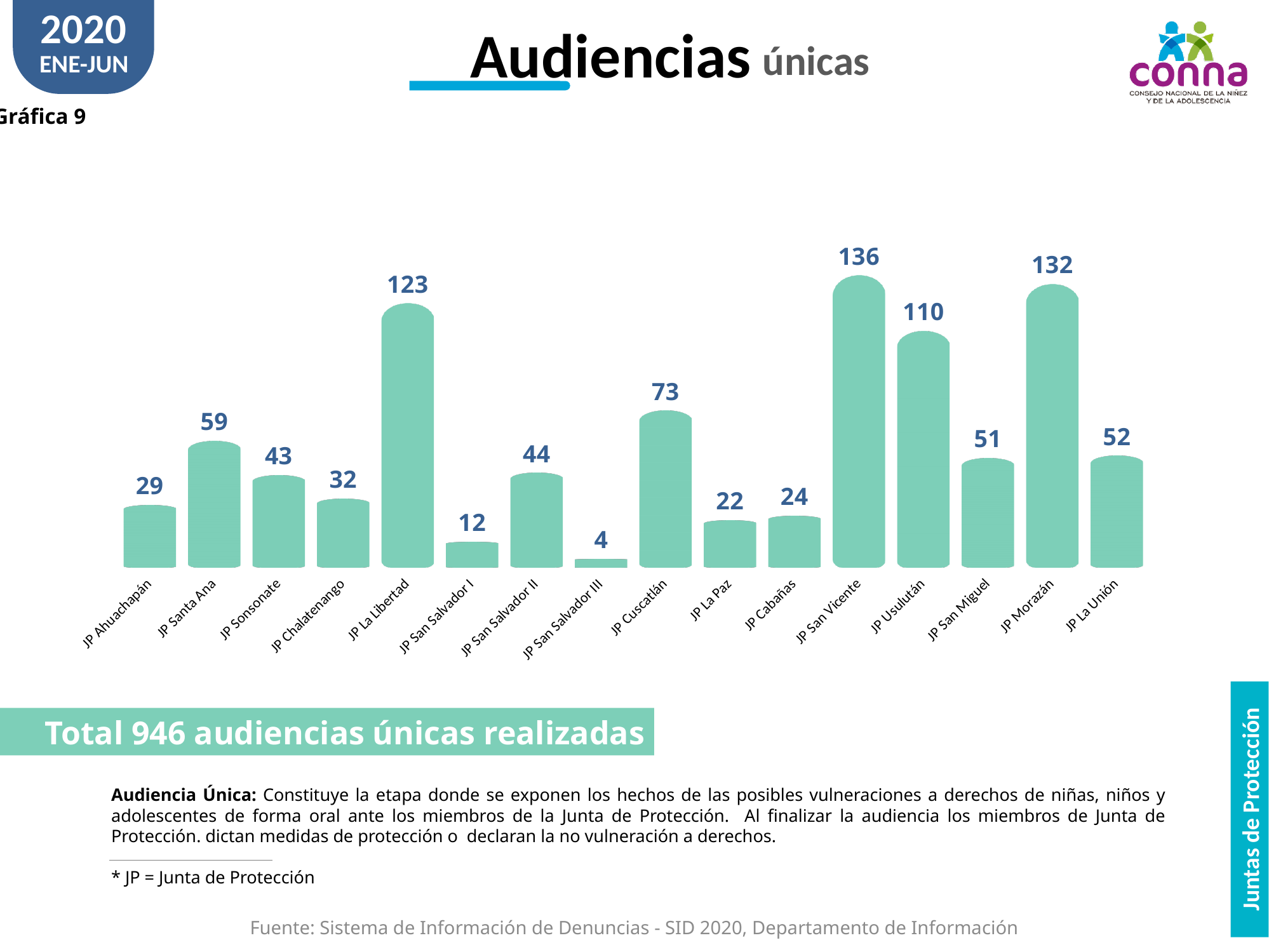
What is the difference between the values for JP San Vicente and JP Morazán? 4 How many categories are shown in the chart? 16 What is the value for JP Cuscatlán? 73 Which category has the highest value? JP San Vicente What is the value for JP La Libertad? 123 What is the value for JP La Unión? 52 Which category has the lowest value? JP San Salvador III What is the difference between the values for JP Usulután and JP Santa Ana? 51 Which is larger, the value for JP Sonsonate or the value for JP San Salvador II? JP San Salvador II What total is stated below the chart? 946 What kind of chart is shown on the slide? Bar chart What is the value for JP San Salvador III? 4